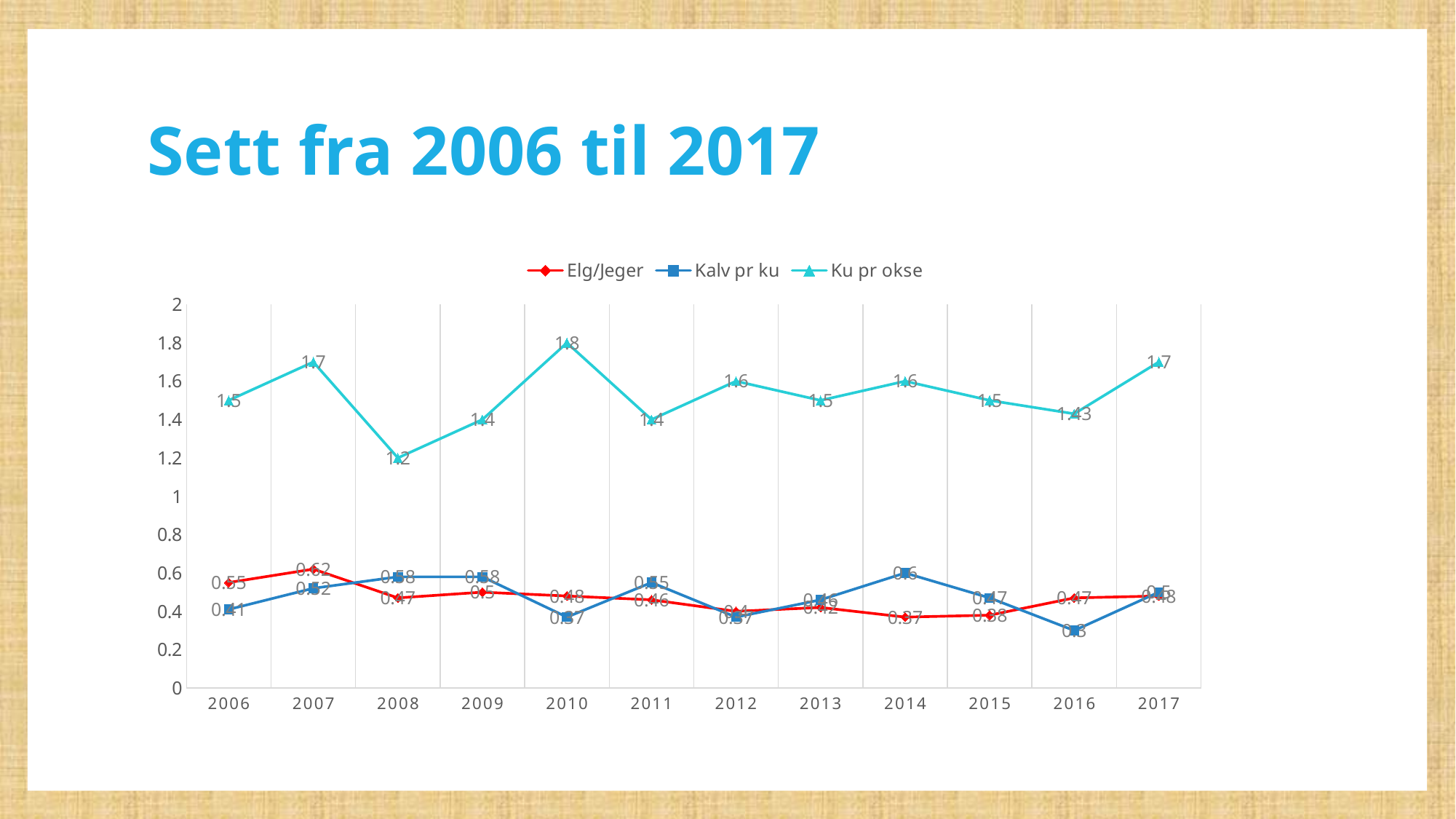
What is the value of Ku pr okse in 2010? 1.8 How many series does the legend list? 3 How many years are plotted along the x axis? 12 What is the value of Ku pr okse in 2016? 1.43 What is the value of Kalv pr ku in 2016? 0.3 What type of chart is shown on the slide? line chart In which year is Ku pr okse at its highest? 2010 In which year is Ku pr okse at its lowest? 2008 Which is larger in 2014: Kalv pr ku or Elg/Jeger? Kalv pr ku What is the difference between the Ku pr okse values in 2010 and 2008? 0.6 Is the value of Ku pr okse in 2008 greater or less than 1.4? less What is the value of Elg/Jeger in 2007? 0.62